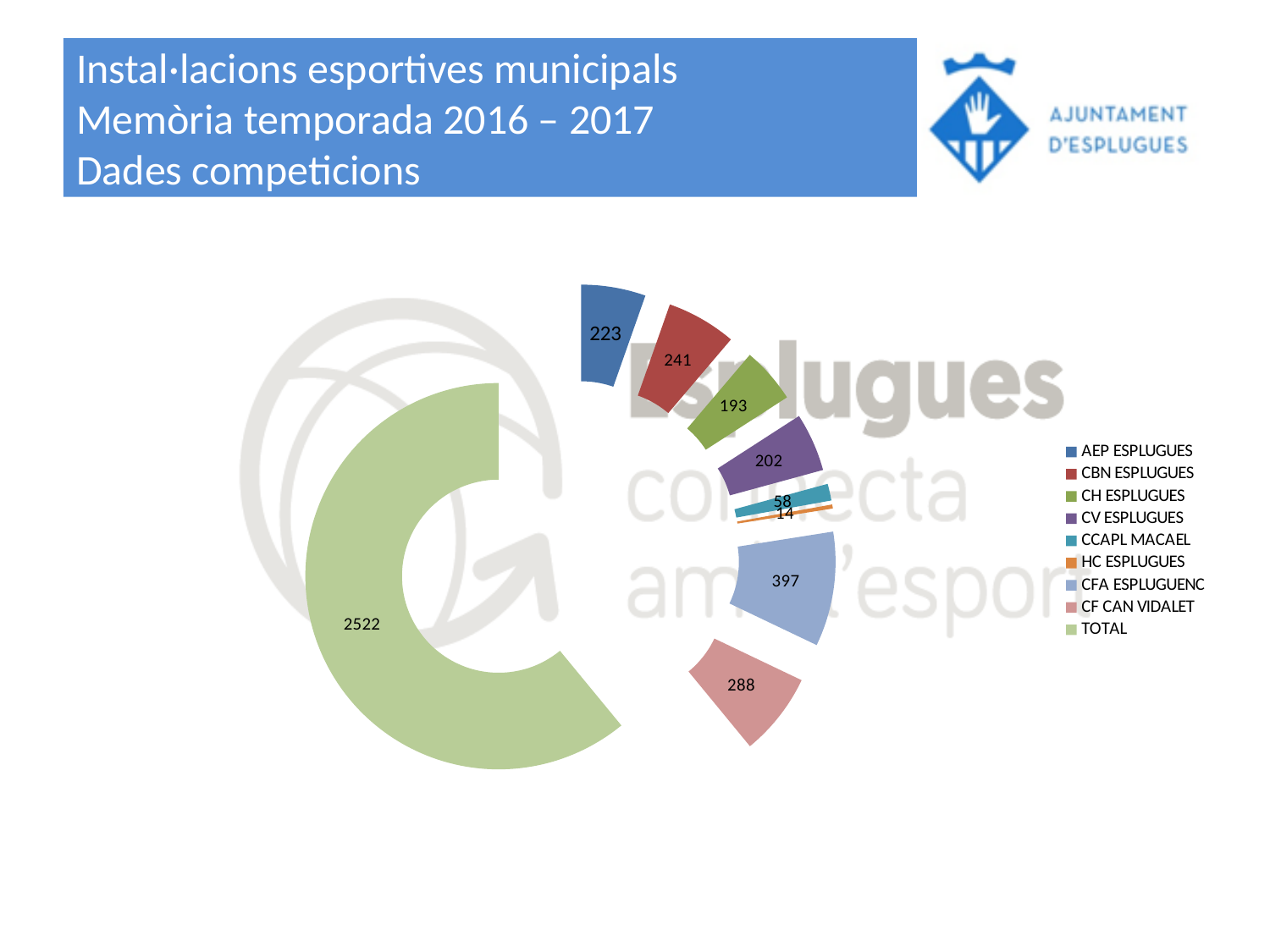
How many entries does the legend list? 9 What colour is the TOTAL slice? light green Which legend entry has the largest slice? TOTAL What is the value for CF CAN VIDALET? 288 Which is larger, the value for AEP ESPLUGUES or the value for CH ESPLUGUES? AEP ESPLUGUES What is the value for HC ESPLUGUES? 14 What kind of chart is shown on the slide? doughnut chart What is the difference between the values for CCAPL MACAEL and HC ESPLUGUES? 44 What is the value for CFA ESPLUGUENC? 397 What is the difference between the values for CFA ESPLUGUENC and CF CAN VIDALET? 109 What is the value for CBN ESPLUGUES? 241 Which legend entry has the smallest slice? HC ESPLUGUES